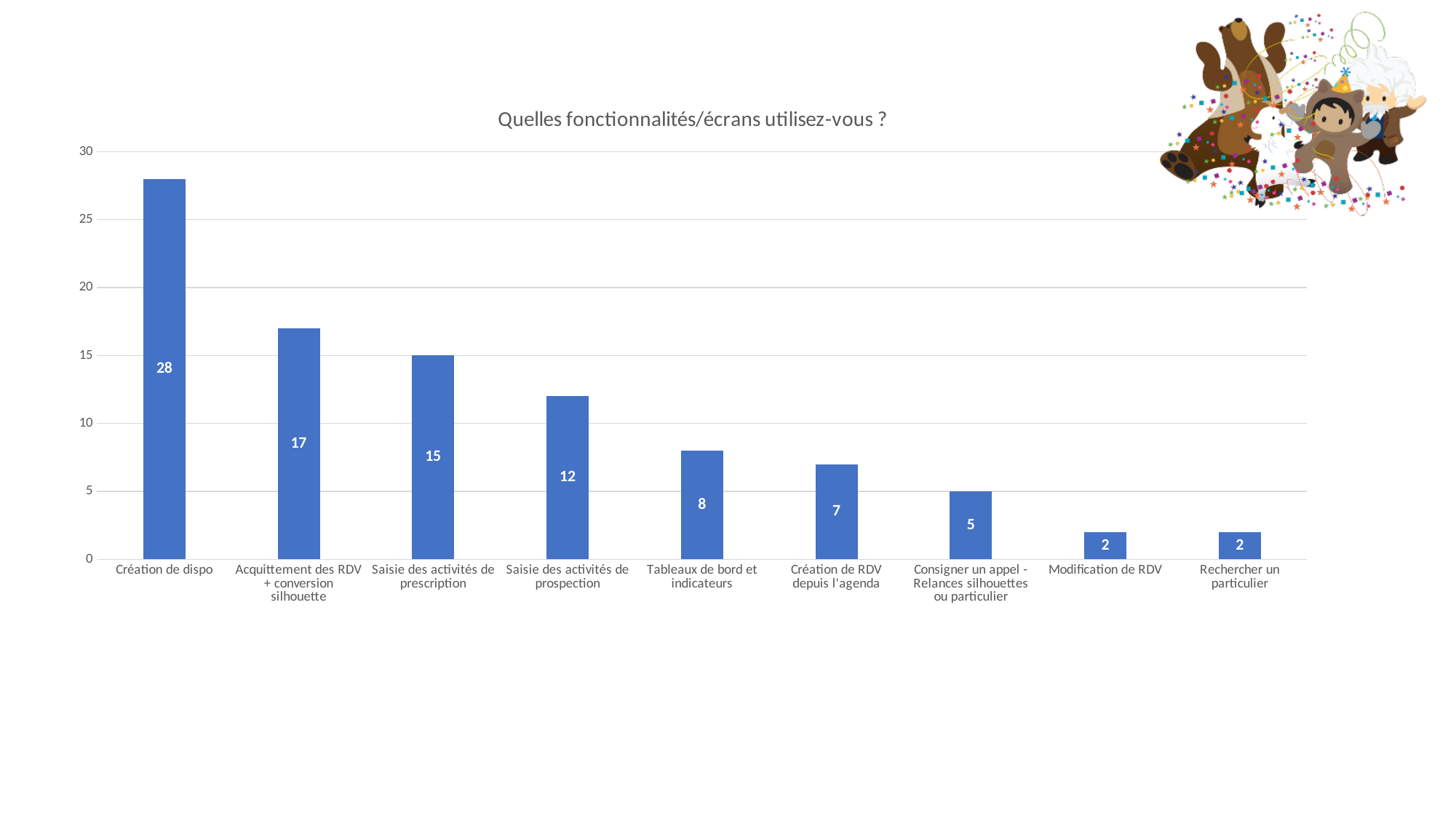
Is the value for Acquittement des RDV + conversion silhouette greater or less than 15? greater What is the title of the chart? Quelles fonctionnalités/écrans utilisez-vous ? What is the value for Création de RDV depuis l'agenda? 7 What is the difference between Tableaux de bord et indicateurs and Consigner un appel - Relances silhouettes ou particulier? 3 Which category has the highest value? Création de dispo What kind of chart is this? bar chart What is the value for Création de dispo? 28 Do the values rise or fall from left to right along the x axis? fall What is the value for Saisie des activités de prospection? 12 Which is larger, Saisie des activités de prescription or Tableaux de bord et indicateurs? Saisie des activités de prescription What is the difference between Création de dispo and Acquittement des RDV + conversion silhouette? 11 How many categories are shown in the chart? 9